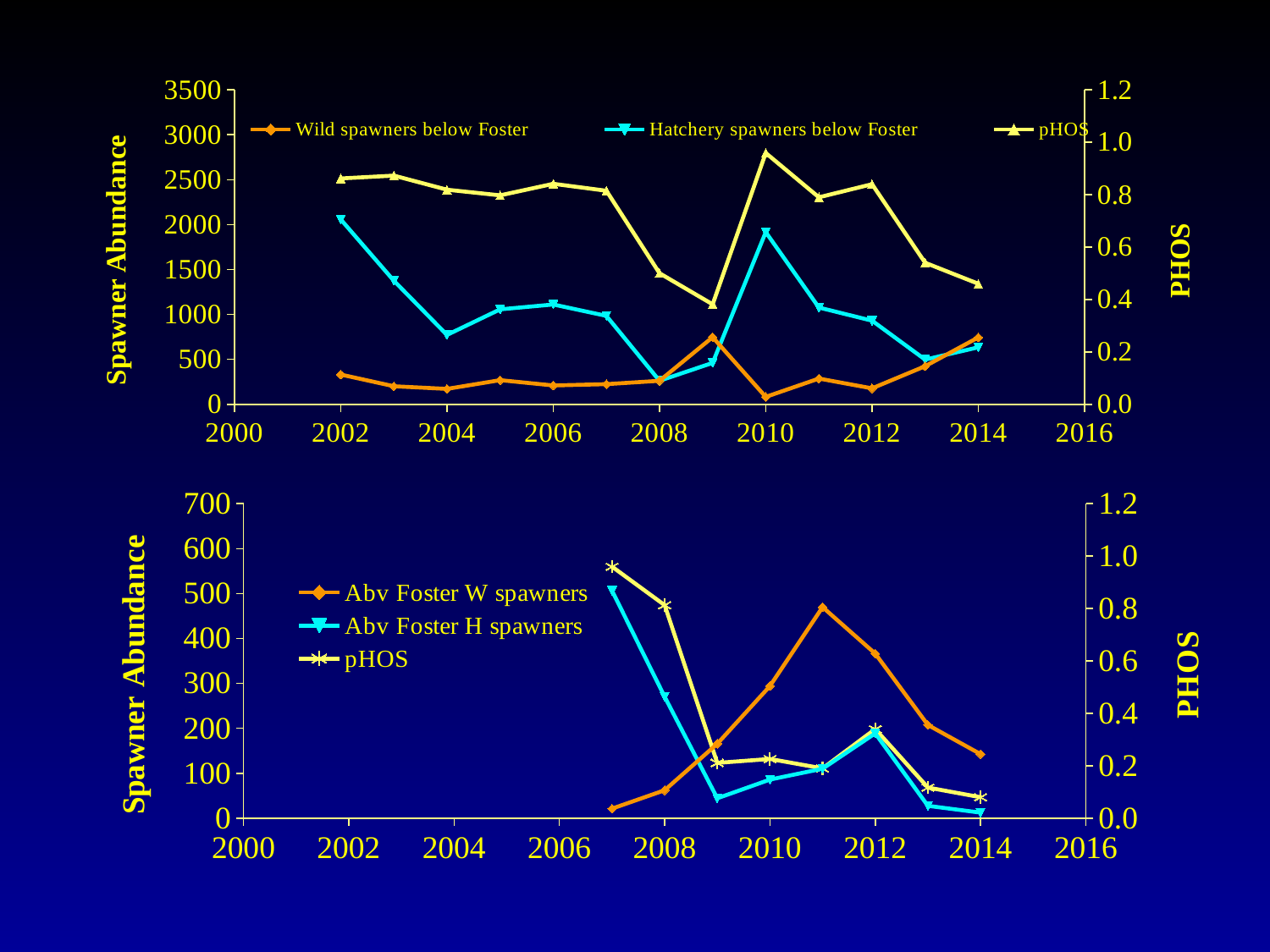
How many series does the legend of the bottom chart list? 3 In the bottom chart, in which year are Abv Foster W spawners highest? 2011 In the top chart, in which year are Wild spawners below Foster lowest? 2010 How many series does the legend of the top chart list? 3 In the top chart, in which year is pHOS highest? 2010 In the bottom chart, is the value for Abv Foster W spawners in 2011 greater or less than 400? greater In the top chart, in which year is pHOS lowest? 2009 In the top chart, is the value for Hatchery spawners below Foster in 2010 greater or less than 1500? greater In the top chart, is the value for Hatchery spawners below Foster in 2004 greater or less than 1000? less In the top chart, do Hatchery spawners below Foster rise or fall from 2002 to 2004? fall In the bottom chart, in 2011, which is larger: Abv Foster W spawners or Abv Foster H spawners? Abv Foster W spawners What kind of chart is the top chart on the slide? line chart